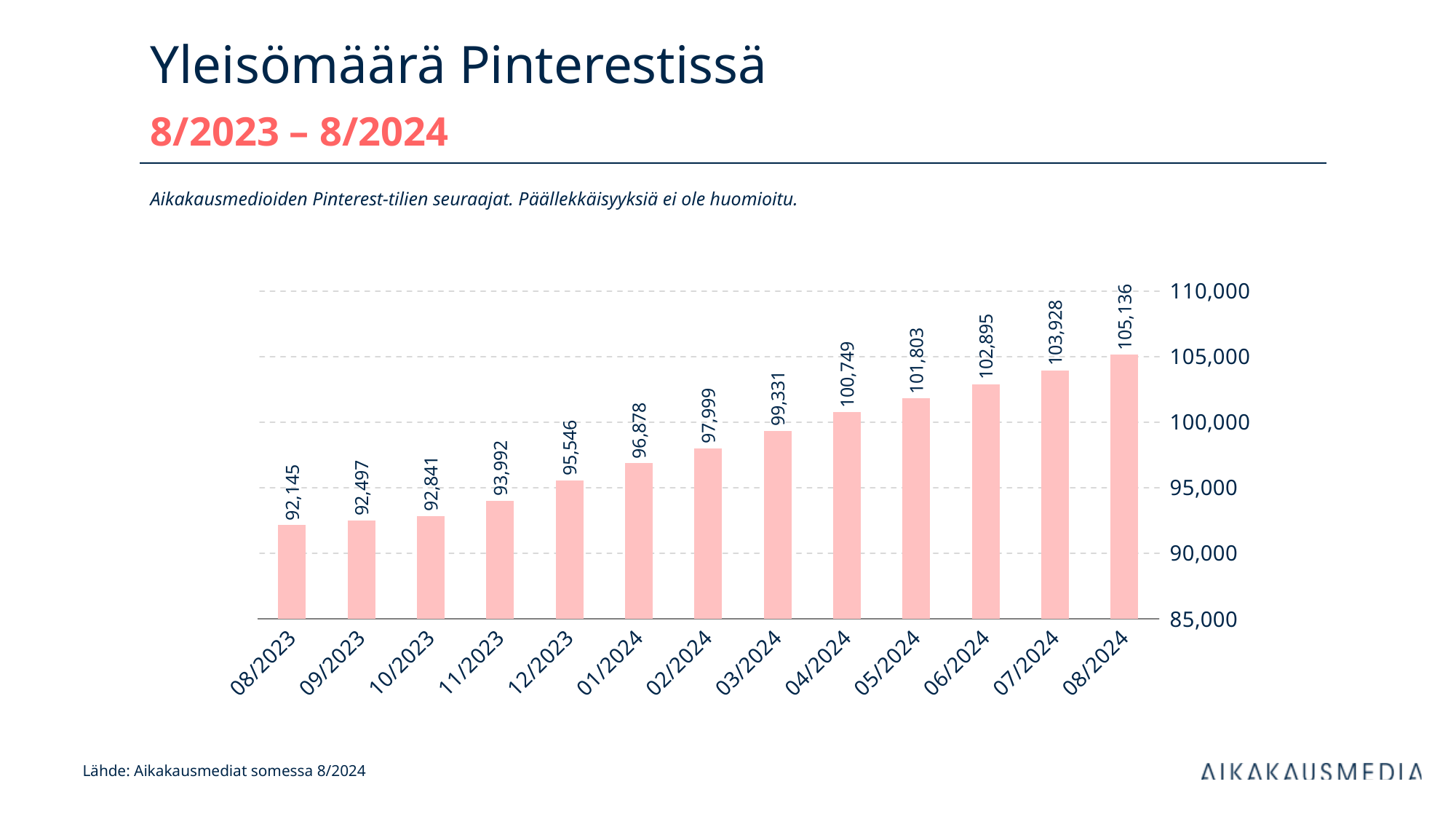
Which month has the highest value? 08/2024 What kind of chart is shown on the slide? bar chart What is the value for 08/2024? 105,136 How many months are shown on the x axis? 13 What is the difference between the values for 04/2024 and 03/2024? 1,418 Which is larger, the value for 12/2023 or the value for 02/2024? 02/2024 Which month has the lowest value? 08/2023 Is the value for 05/2024 greater or less than 100,000? greater What is the value for 01/2024? 96,878 What is the value for 08/2023? 92,145 Do the values rise or fall from 08/2023 to 08/2024? rise What is the difference between the values for 08/2024 and 08/2023? 12,991